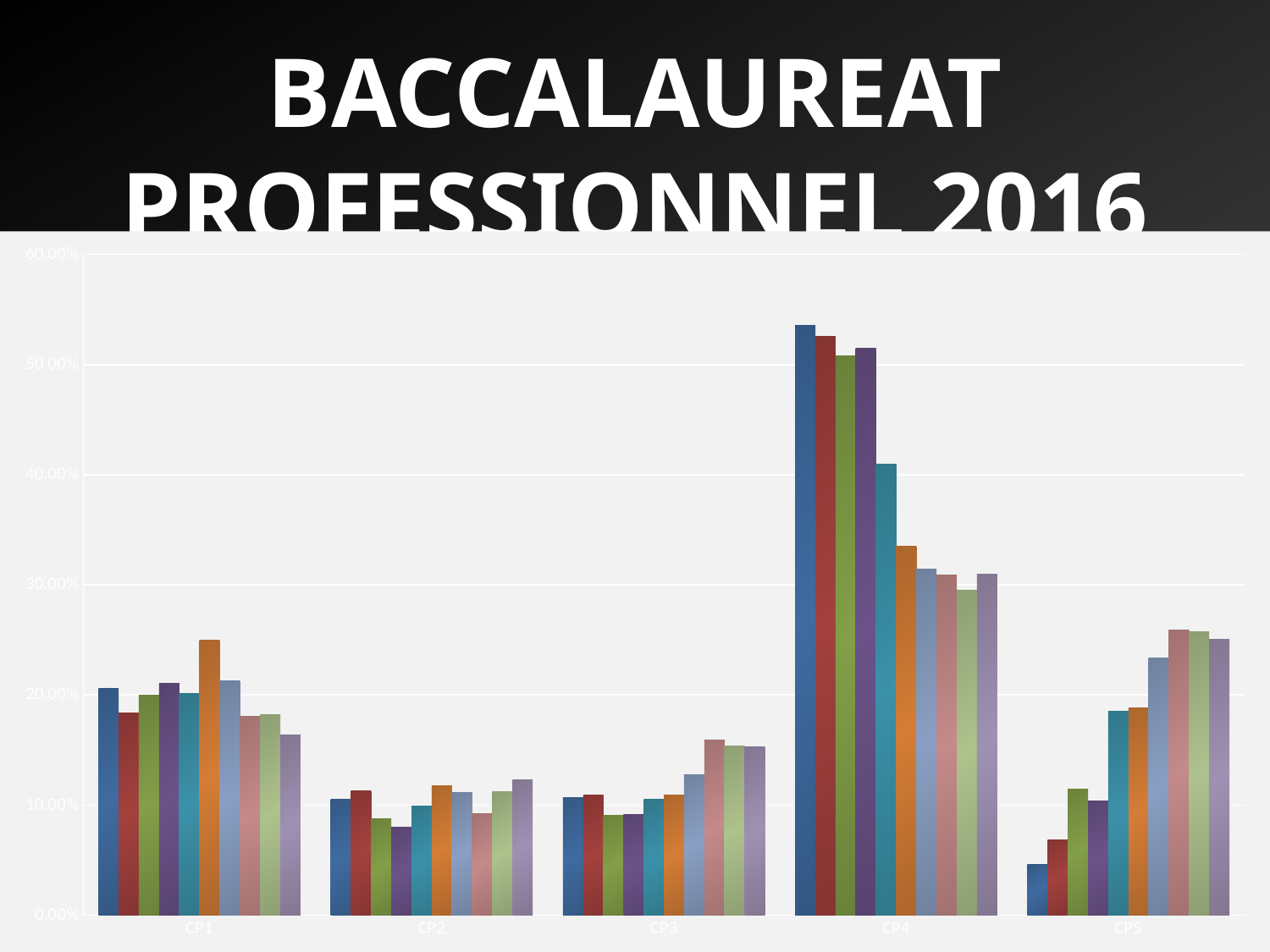
Is the tallest bar for CP1 greater or less than 20.00%? greater Which category contains the shortest bar in the chart? CP5 Is the tallest bar for CP4 greater or less than 50.00%? greater Is the tallest bar for CP2 greater or less than 20.00%? less How many bars are plotted for each category in the chart? 10 Which category has the tallest bars in the chart? CP4 How many categories are shown on the x axis of the chart? 5 Which category has taller bars overall, CP4 or CP2? CP4 What is the title shown above the chart? BACCALAUREAT PROFESSIONNEL 2016 What kind of chart is shown on the slide? bar chart